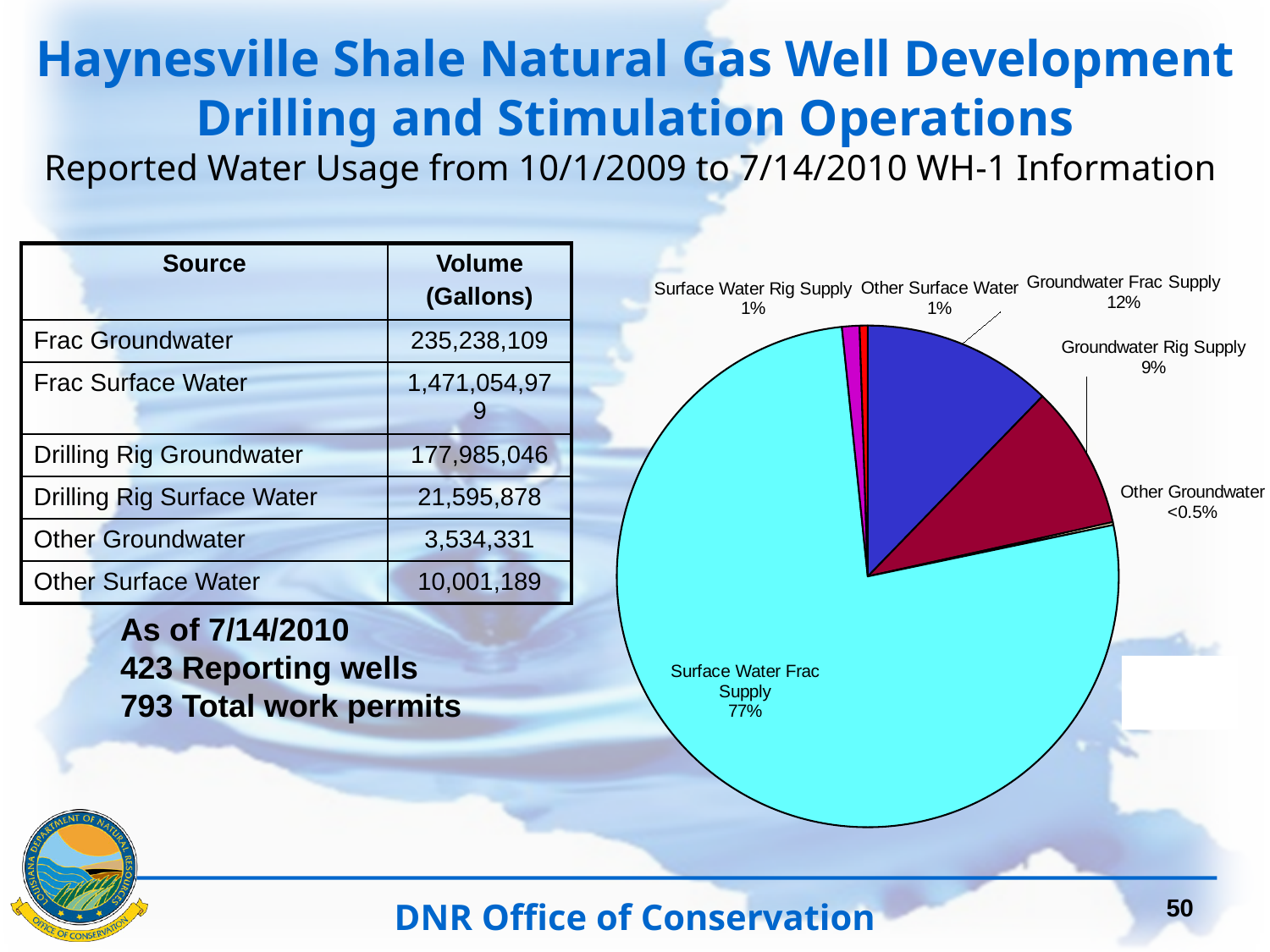
How many slices does the pie chart have? 6 What percentage is shown for Surface Water Rig Supply in the pie chart? 1% What colour is the Surface Water Frac Supply slice in the pie chart? Light blue (cyan) What kind of chart is shown on the slide? Pie chart What share of the pie chart is Surface Water Frac Supply? 77% In the pie chart, how many percentage points larger is Surface Water Frac Supply than Groundwater Frac Supply? 65 percentage points Which slice of the pie chart is the largest? Surface Water Frac Supply What percentage is shown for Groundwater Rig Supply in the pie chart? 9% What percentage is shown for Groundwater Frac Supply in the pie chart? 12% In the pie chart, which is larger: Groundwater Frac Supply or Groundwater Rig Supply? Groundwater Frac Supply Which slice of the pie chart is the smallest? Other Groundwater What percentage is shown for Other Groundwater in the pie chart? <0.5%